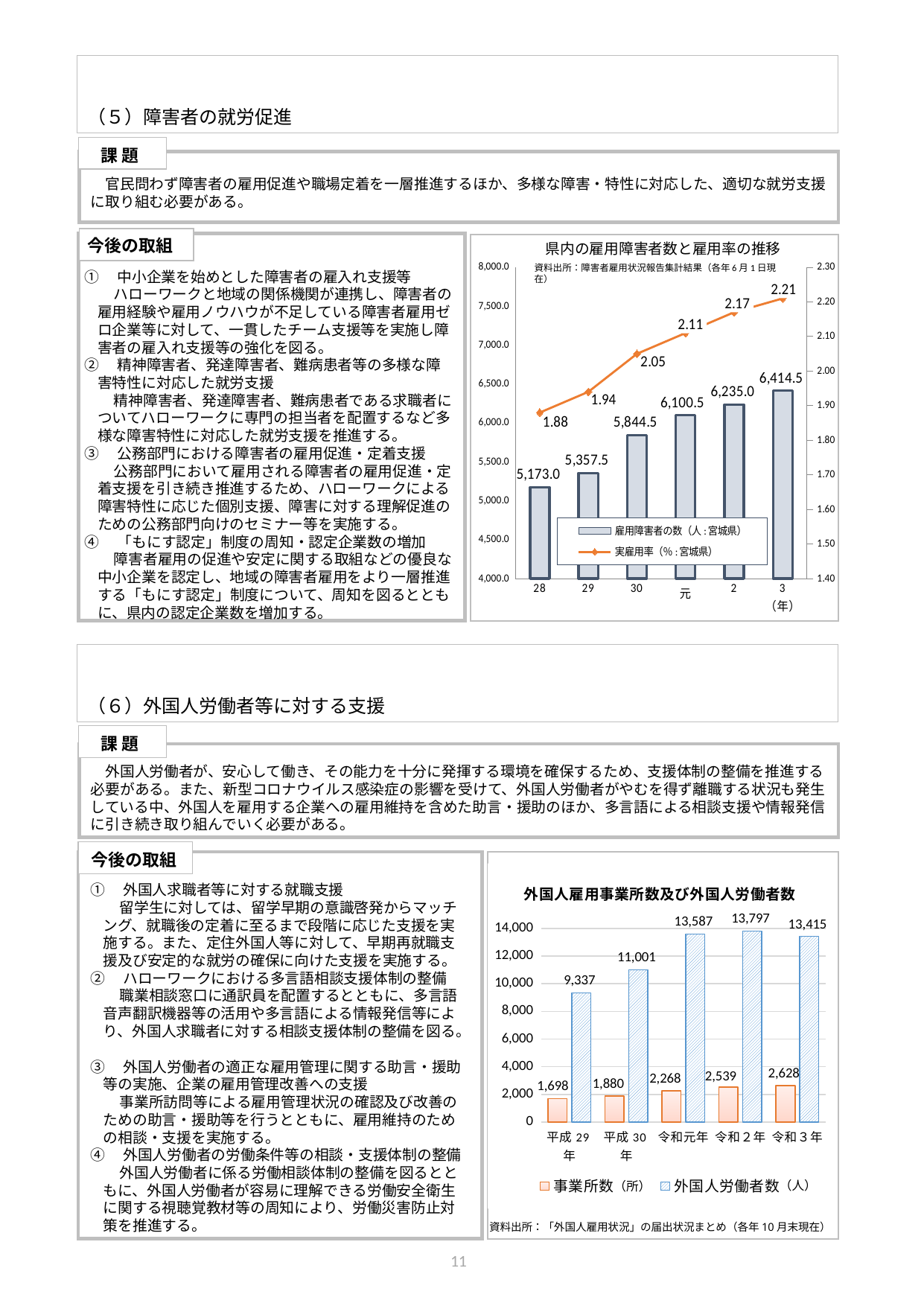
In the chart titled 県内の雇用障害者数と雇用率の推移, what is the 実雇用率 value for year 28? 1.88 In the chart titled 外国人雇用事業所数及び外国人労働者数, what is the difference in 外国人労働者数 between 令和２年 and 令和３年? 382 In the chart titled 県内の雇用障害者数と雇用率の推移, how many series does the legend list? 2 In the chart titled 県内の雇用障害者数と雇用率の推移, what is the value of 雇用障害者の数 for year 3? 6,414.5 What kind of chart is the one titled 外国人雇用事業所数及び外国人労働者数? bar chart In the chart titled 県内の雇用障害者数と雇用率の推移, what is the difference in 雇用障害者の数 between year 30 and year 29? 487.0 In the chart titled 県内の雇用障害者数と雇用率の推移, does the 実雇用率 rise or fall from year 28 to year 3? rise In the chart titled 外国人雇用事業所数及び外国人労働者数, how many years are shown on the x axis? 5 In the chart titled 外国人雇用事業所数及び外国人労働者数, which year has the highest 外国人労働者数? 令和２年 In the chart titled 県内の雇用障害者数と雇用率の推移, which year has the lowest 雇用障害者の数? 28 In the chart titled 外国人雇用事業所数及び外国人労働者数, what is the 事業所数 for 平成29年? 1,698 In the chart titled 外国人雇用事業所数及び外国人労働者数, what is the 外国人労働者数 for 令和２年? 13,797